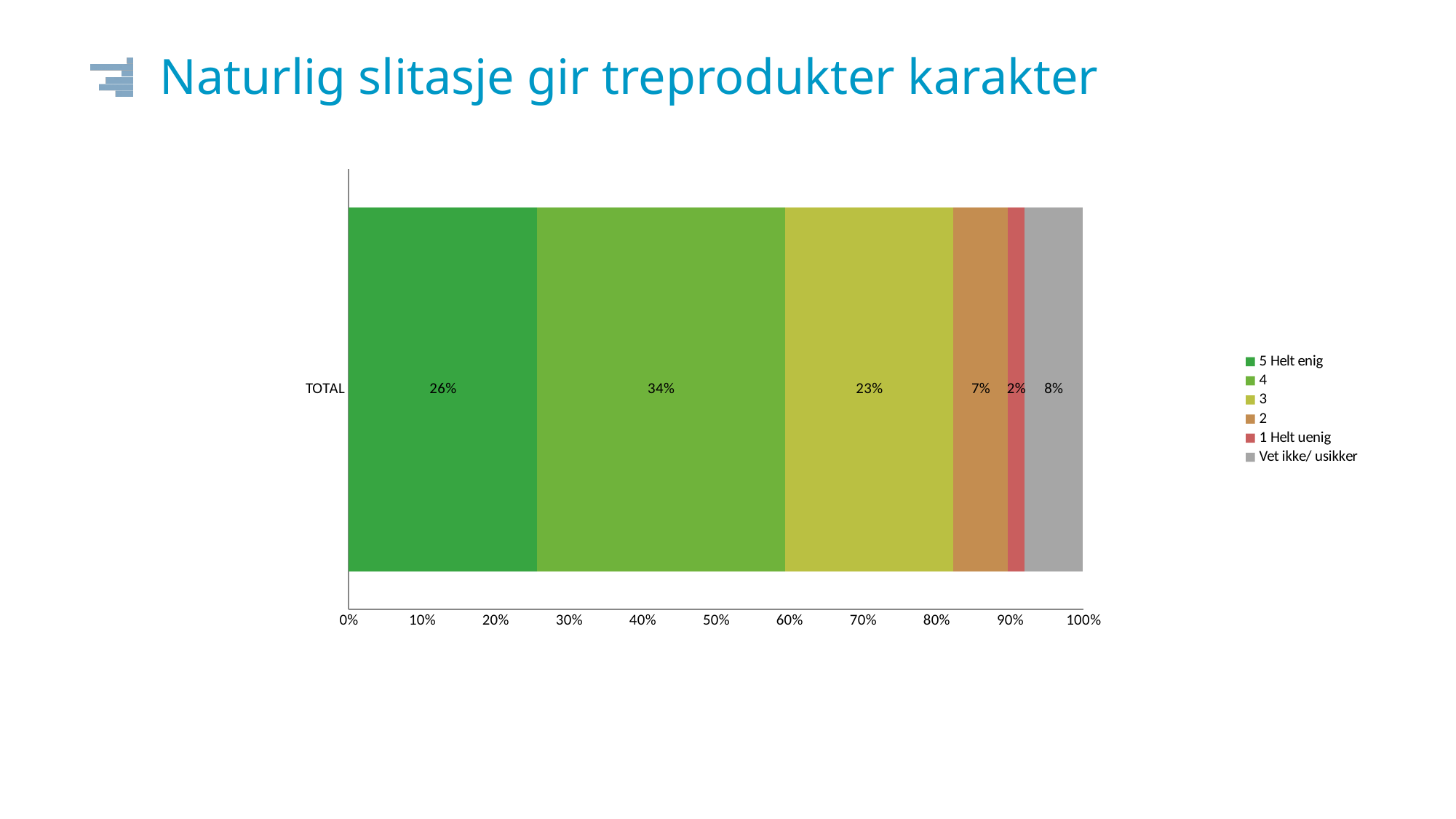
Which response category has the largest share? 4 What percentage of respondents answered "Vet ikke/ usikker"? 8% How many series does the legend list? 6 What percentage of respondents answered "4"? 34% What percentage of respondents answered "3"? 23% What is the difference between the share for "4" and the share for "5 Helt enig"? 8% Which is larger, the share for "2" or the share for "Vet ikke/ usikker"? Vet ikke/ usikker What is the title of the slide? Naturlig slitasje gir treprodukter karakter What percentage of respondents answered "1 Helt uenig"? 2% What percentage of respondents answered "5 Helt enig"? 26% What kind of chart is shown on the slide? Stacked bar chart Which response category has the smallest share? 1 Helt uenig